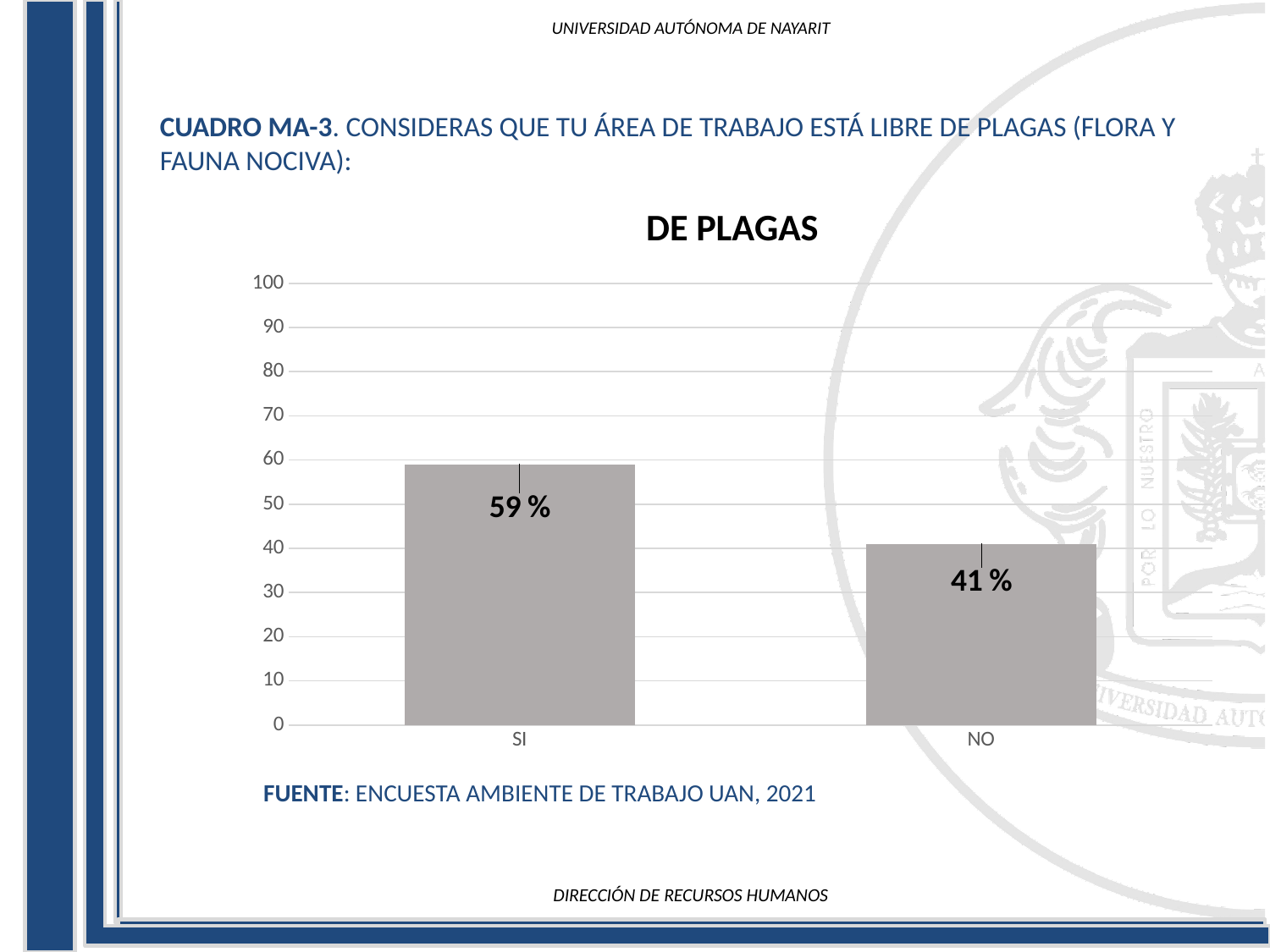
Is the value for SI greater or less than 50? greater What is the highest value shown on the y axis? 100 What is the value for SI? 59 % What is the title of the chart? DE PLAGAS Which category has the lowest value? NO What is the value for NO? 41 % What kind of chart is shown? bar chart Which is larger, the value for SI or the value for NO? SI How many categories are shown on the x axis? 2 Is the value for NO greater or less than 50? less Which category has the highest value? SI What is the difference between the values for SI and NO? 18 %